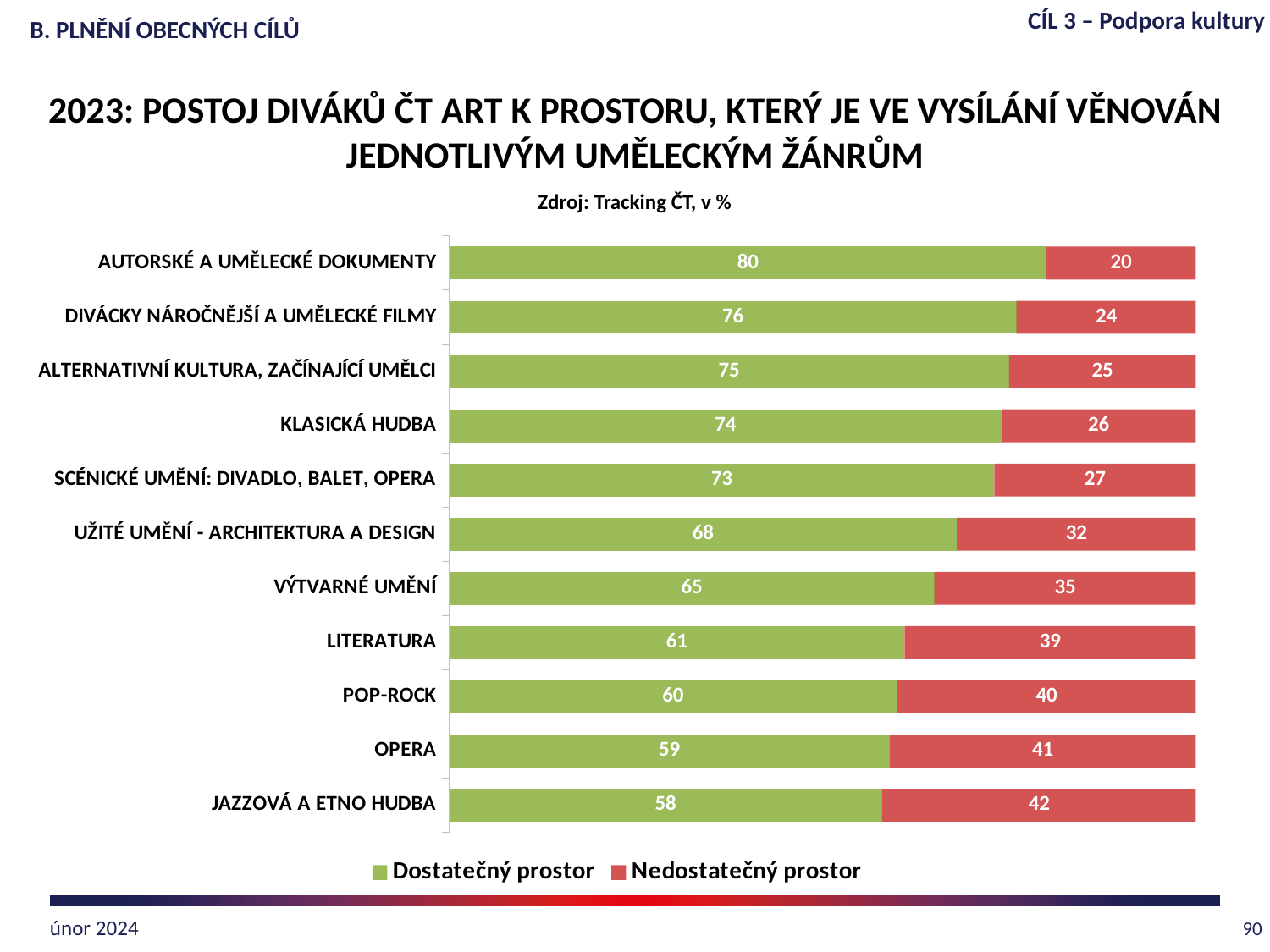
Which category has the lowest value for "Dostatečný prostor"? JAZZOVÁ A ETNO HUDBA What is the value of "Dostatečný prostor" for KLASICKÁ HUDBA? 74 How many categories are shown in the chart? 11 Which colour represents "Nedostatečný prostor" in the chart? Red How many series does the legend list? 2 What kind of chart is shown on the slide? Stacked bar chart Which category has the highest value for "Dostatečný prostor"? AUTORSKÉ A UMĚLECKÉ DOKUMENTY Which category has the highest value for "Nedostatečný prostor"? JAZZOVÁ A ETNO HUDBA What is the value of "Nedostatečný prostor" for LITERATURA? 39 Which is larger: the "Nedostatečný prostor" value for VÝTVARNÉ UMĚNÍ or for OPERA? OPERA What is the difference between the "Dostatečný prostor" values for AUTORSKÉ A UMĚLECKÉ DOKUMENTY and POP-ROCK? 20 What is the total of the stacked bar for SCÉNICKÉ UMĚNÍ: DIVADLO, BALET, OPERA? 100